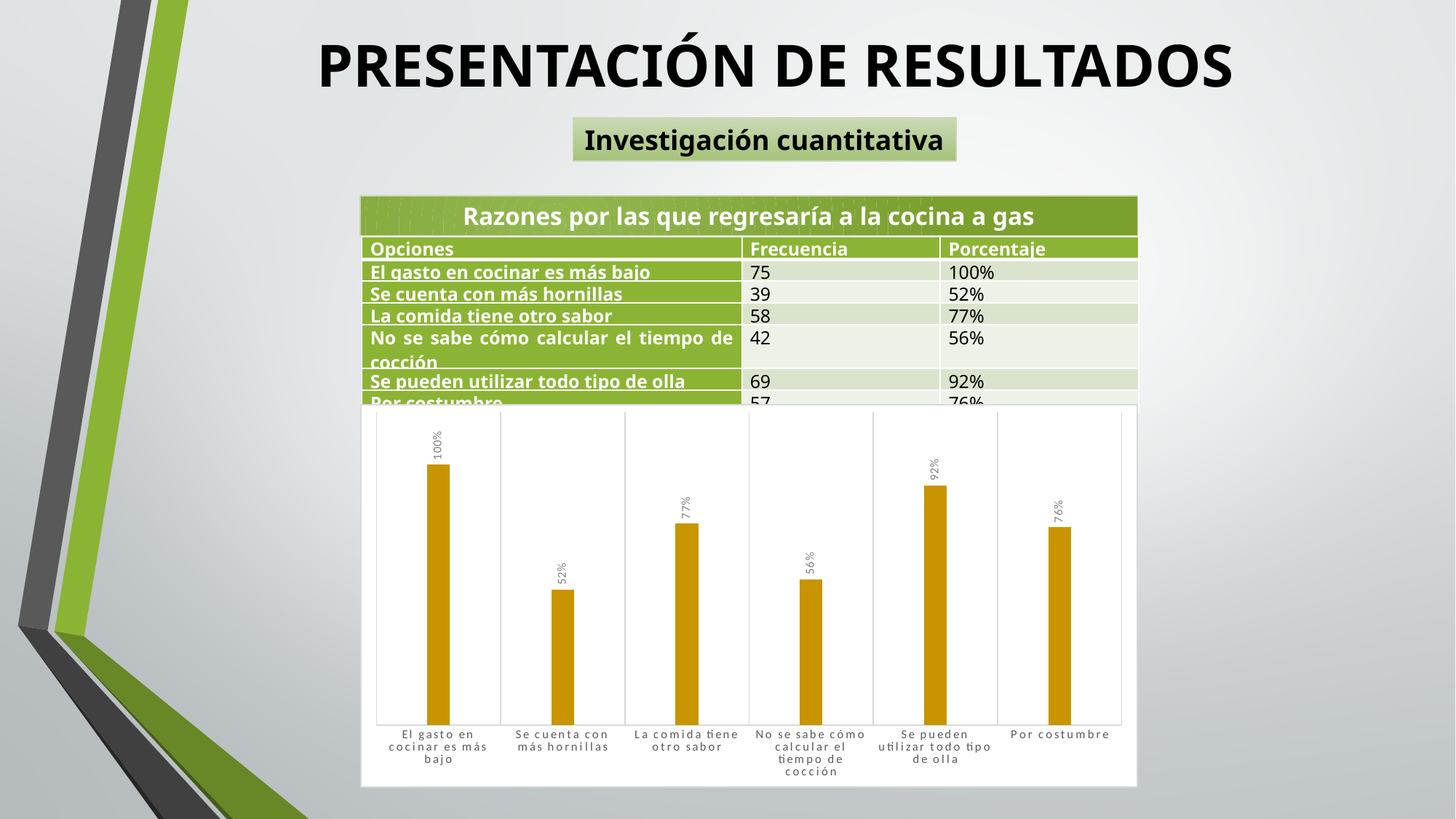
Which category has the lowest value in the bar chart? Se cuenta con más hornillas What is the value for 'Se pueden utilizar todo tipo de olla' in the bar chart? 92% Which category has the highest value in the bar chart? El gasto en cocinar es más bajo What is the value for 'Por costumbre' in the bar chart? 76% What is the value for 'El gasto en cocinar es más bajo' in the bar chart? 100% How many categories are shown in the bar chart? 6 What is the difference between the values for 'Se pueden utilizar todo tipo de olla' and 'No se sabe cómo calcular el tiempo de cocción' in the bar chart? 36% Which is larger in the bar chart: 'La comida tiene otro sabor' or 'Por costumbre'? La comida tiene otro sabor What is the value for 'La comida tiene otro sabor' in the bar chart? 77% What colour are the bars in the chart? Gold/orange What kind of chart is shown on the slide? Bar chart What is the value for 'Se cuenta con más hornillas' in the bar chart? 52%